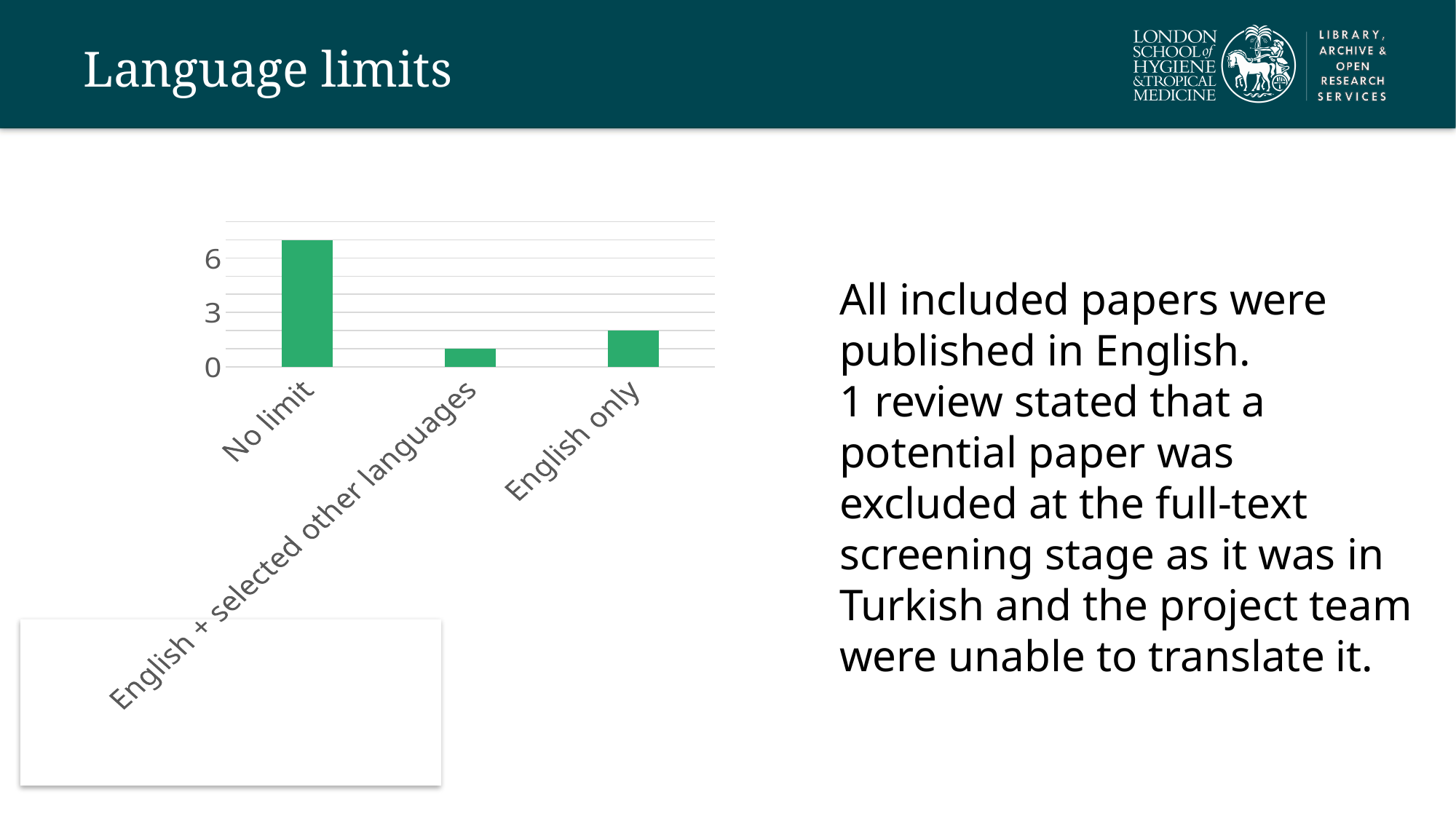
What is the highest tick label shown on the y axis of the chart? 6 Is the value for No limit greater or less than 6? greater What kind of chart is shown on the slide? bar chart Which is larger, the value for English only or the value for English + selected other languages? English only How many categories are shown on the x axis of the chart? 3 Is the value for No limit greater or less than 3? greater What colour are the bars in the chart? green Which category has the lowest bar in the chart? English + selected other languages Which category has the highest bar in the chart? No limit Which is larger, the value for No limit or the value for English only? No limit Is the value for English + selected other languages greater or less than 3? less